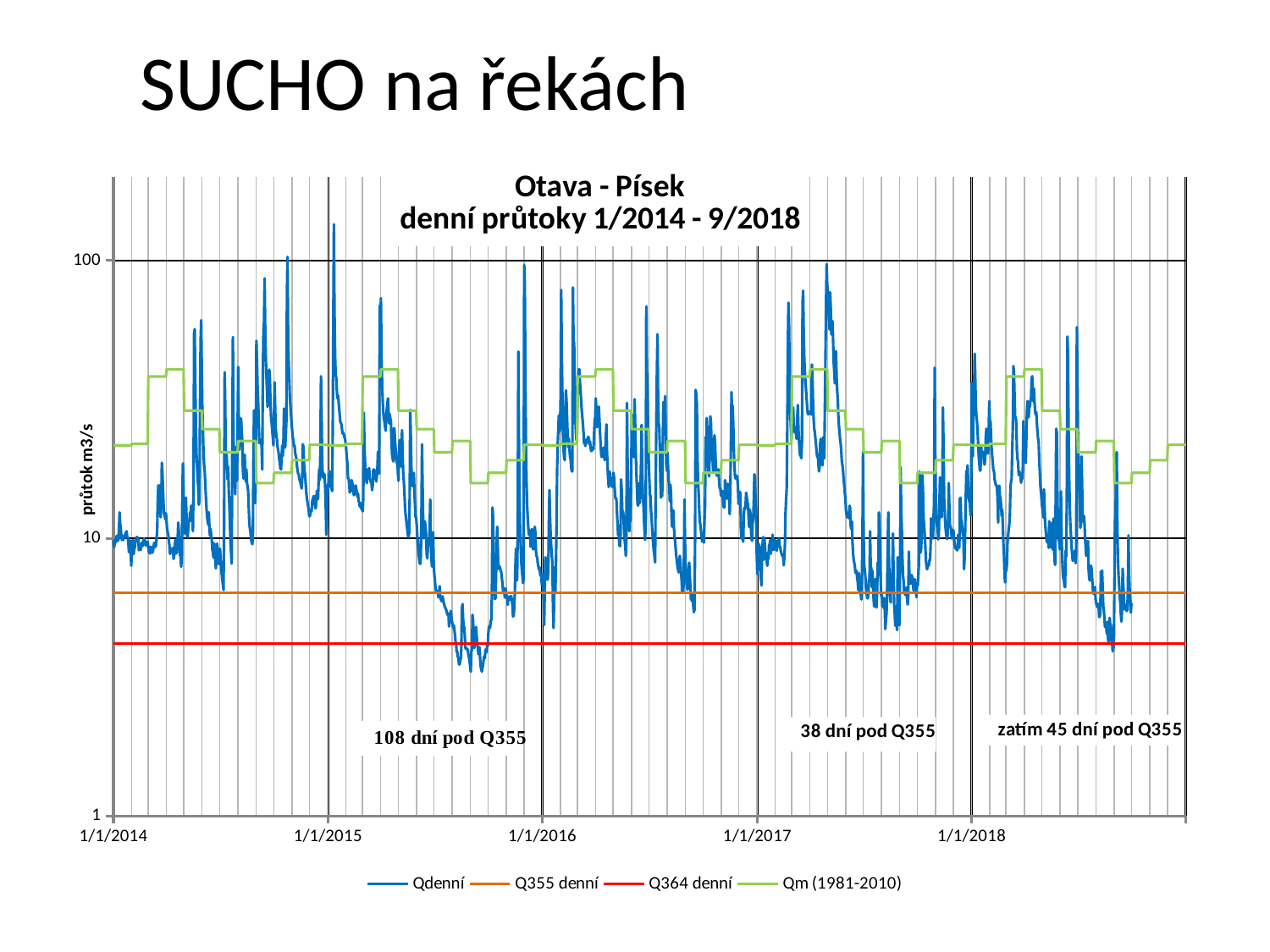
Is the value of the Q364 denní line greater or less than 10? less How many days below Q355 does the annotation for the 2015 drought period state? 108 dní How many series does the legend of the chart list? 4 How many days below Q355 does the annotation for the 2017 drought period state? 38 dní Is the Qm (1981-2010) line greater or less than 10 throughout the chart? greater What is the label of the vertical axis of the chart? průtok m3/s Which line is higher, Q355 denní or Q364 denní? Q355 denní Which annotated drought period has the highest number of days below Q355? 108 dní pod Q355 (2015) Is the value of the Q355 denní line greater or less than 10? less What is the title of the chart? Otava - Písek denní průtoky 1/2014 - 9/2018 Which line is higher, Qm (1981-2010) or Q355 denní? Qm (1981-2010) What kind of chart is shown on the slide? line chart